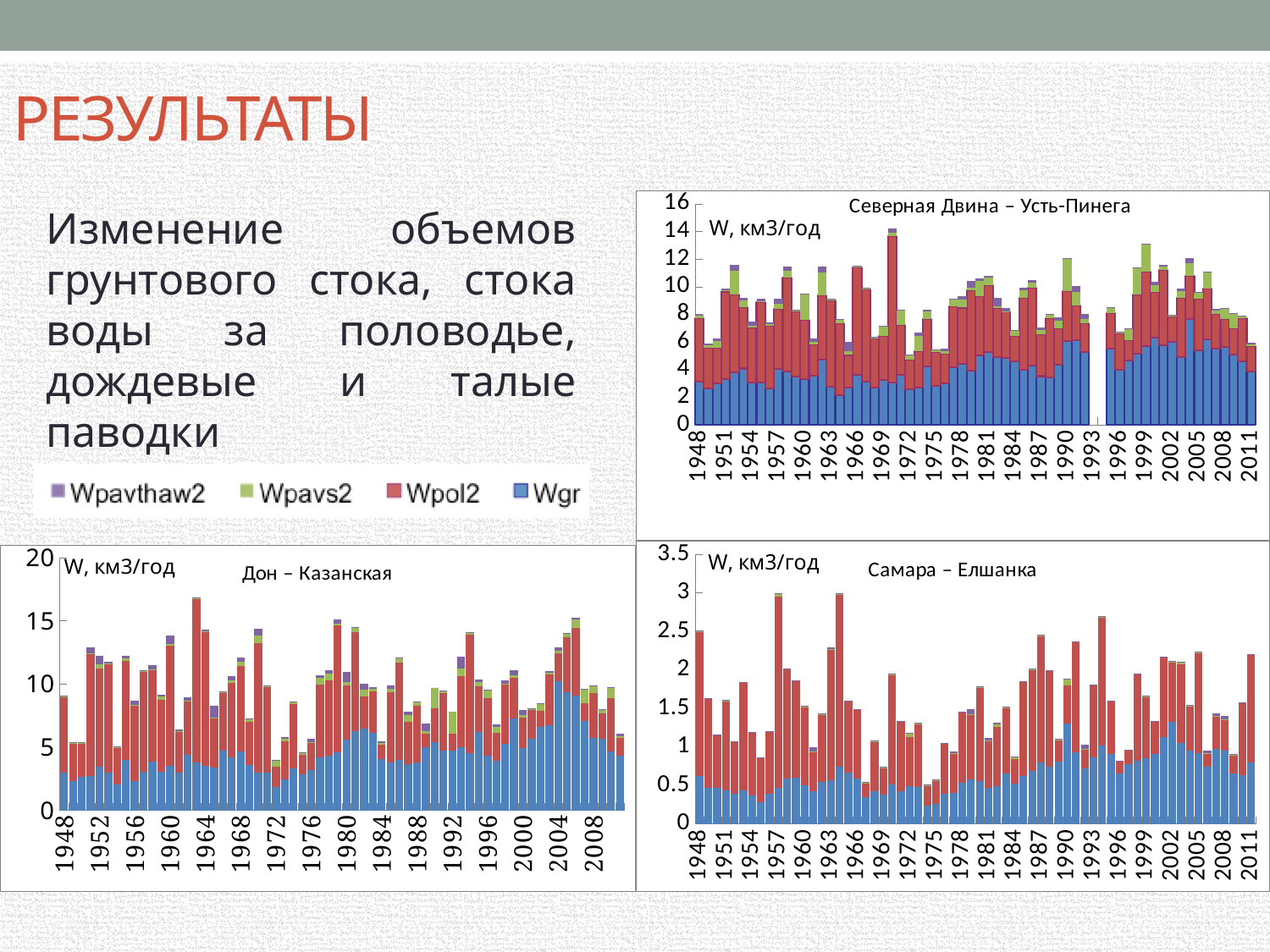
What is the title of the chart in the top right of the slide? Северная Двина – Усть-Пинега What kind of chart is the 'Дон – Казанская' chart? Stacked bar chart In the 'Дон – Казанская' chart, is the total value for 1964 greater or less than 15? less In the 'Самара – Елшанка' chart, is the total value for 1957 greater or less than 2.5? greater In the 'Самара – Елшанка' chart, is the total value for 1975 greater or less than 1? less How many series does the legend list for the charts? 4 In the 'Северная Двина – Усть-Пинега' chart, which year has the highest total bar? 1970 What is the y-axis label on the 'Самара – Елшанка' chart? W, км3/год In the 'Дон – Казанская' chart, which year has the highest total bar? 1963